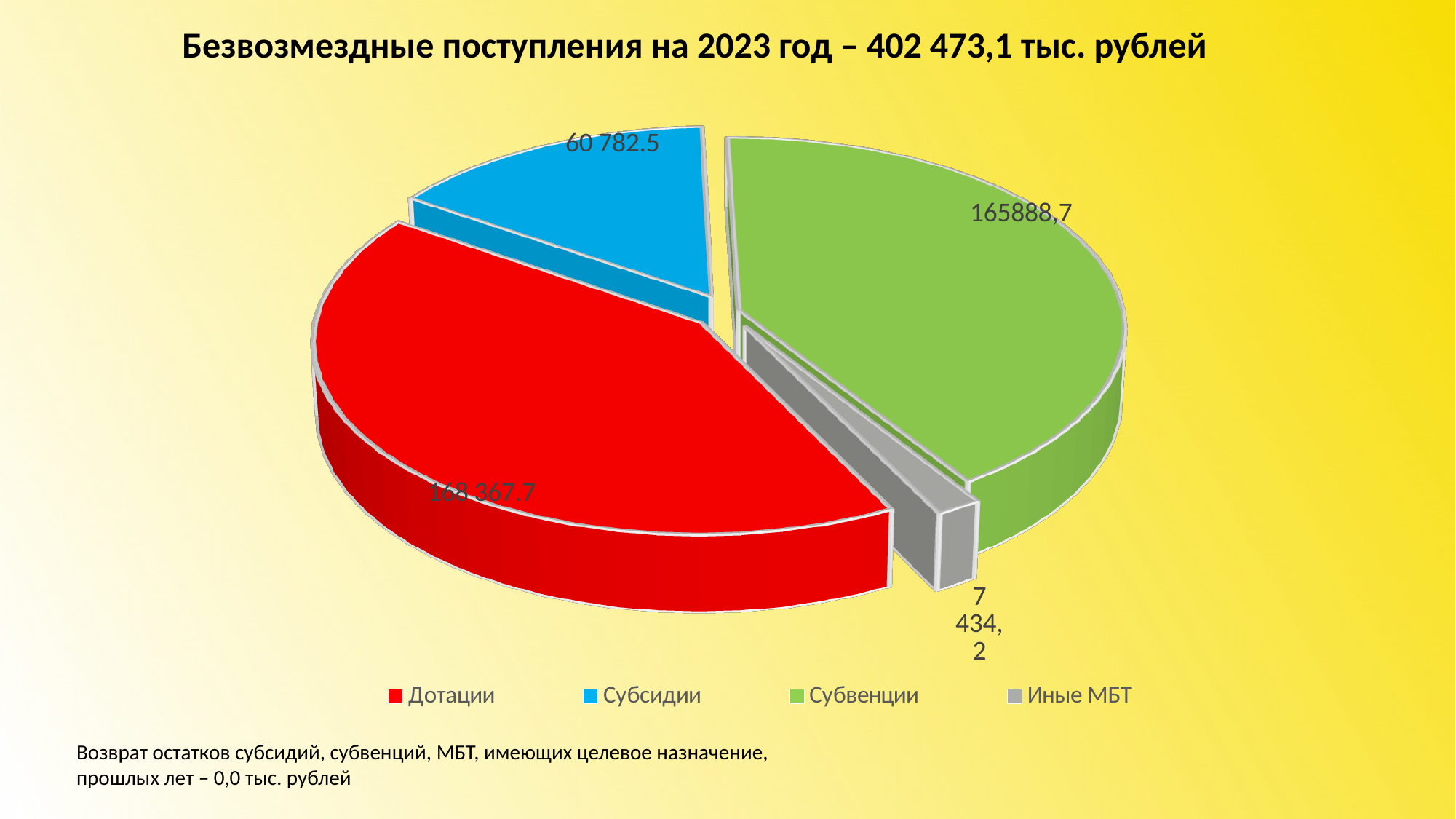
What is the value for Дотации? 168 367.7 Which category has the smallest slice of the pie? Иные МБТ What total amount is stated in the chart title for 2023? 402 473,1 тыс. рублей What is the value for Субсидии? 60 782.5 What is the difference between the values for Дотации and Субсидии? 107 585.2 What is the value for Иные МБТ? 7 434,2 What kind of chart is shown on the slide? Pie chart Which is larger, Субсидии or Иные МБТ? Субсидии How many categories does the pie chart have? 4 Which category has the largest value? Дотации What is the value for Субвенции? 165888,7 How many entries does the legend list? 4